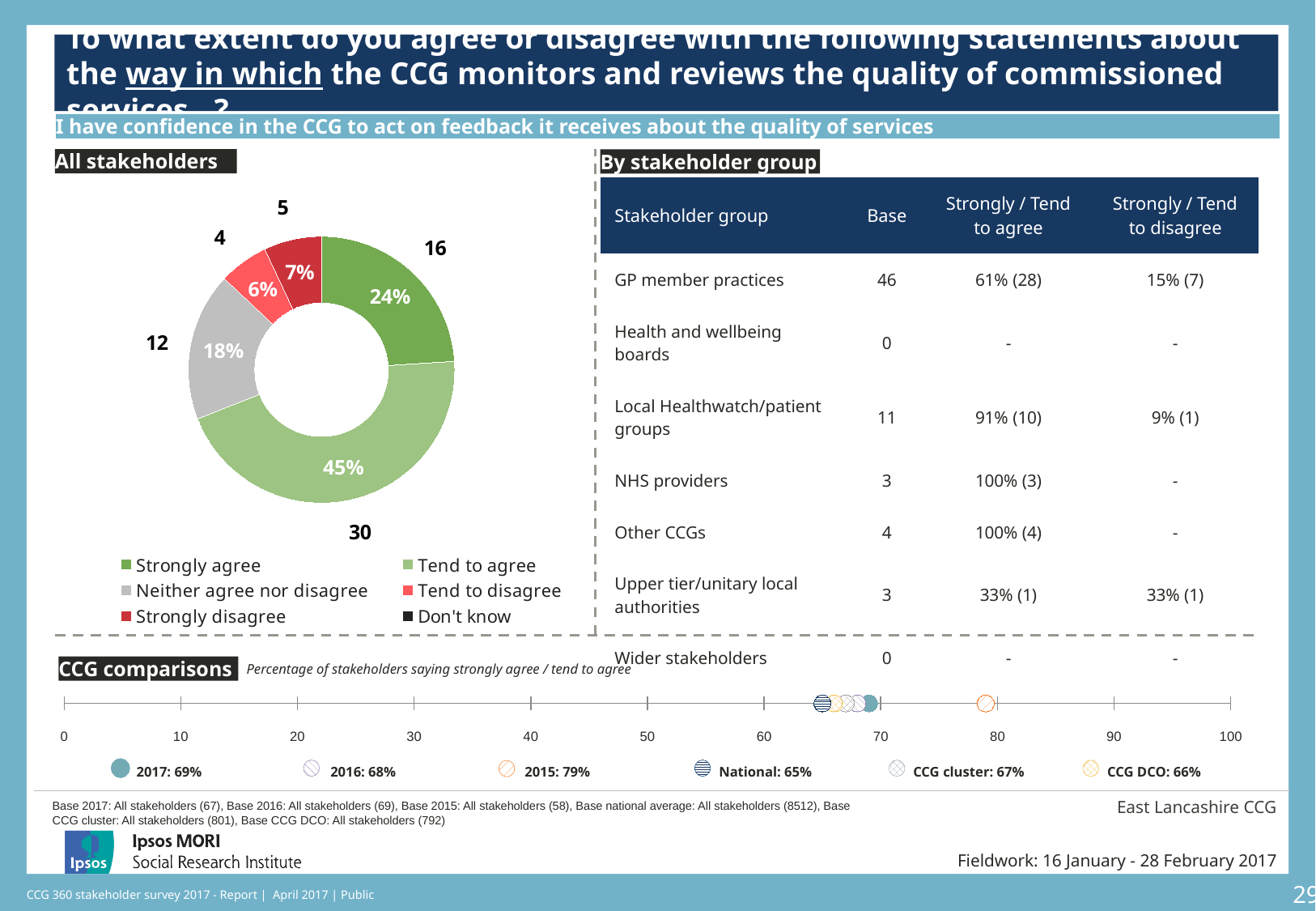
In the 'All stakeholders' donut chart, what percentage of stakeholders said 'Strongly agree'? 24% In the 'CCG comparisons' chart, which comparison point has the lowest value? National: 65% How many response categories does the legend of the 'All stakeholders' donut chart list? 6 In the 'All stakeholders' donut chart, which is larger: the share for 'Strongly disagree' or the share for 'Tend to disagree'? Strongly disagree In the 'CCG comparisons' chart, what is the difference between the 2017 value and the National value? 4 percentage points In the 'All stakeholders' donut chart, what percentage of stakeholders said 'Tend to agree'? 45% In the 'All stakeholders' donut chart, what is the difference in percentage points between 'Tend to agree' and 'Strongly agree'? 21 In the 'All stakeholders' donut chart, how many stakeholders said 'Neither agree nor disagree'? 12 In the 'All stakeholders' donut chart, which response category has the largest share? Tend to agree In the 'All stakeholders' donut chart, what is the combined percentage for 'Strongly agree' and 'Tend to agree'? 69% In the 'CCG comparisons' chart, what is the 2015 value? 79% What type of chart is used in the 'All stakeholders' section? Donut chart